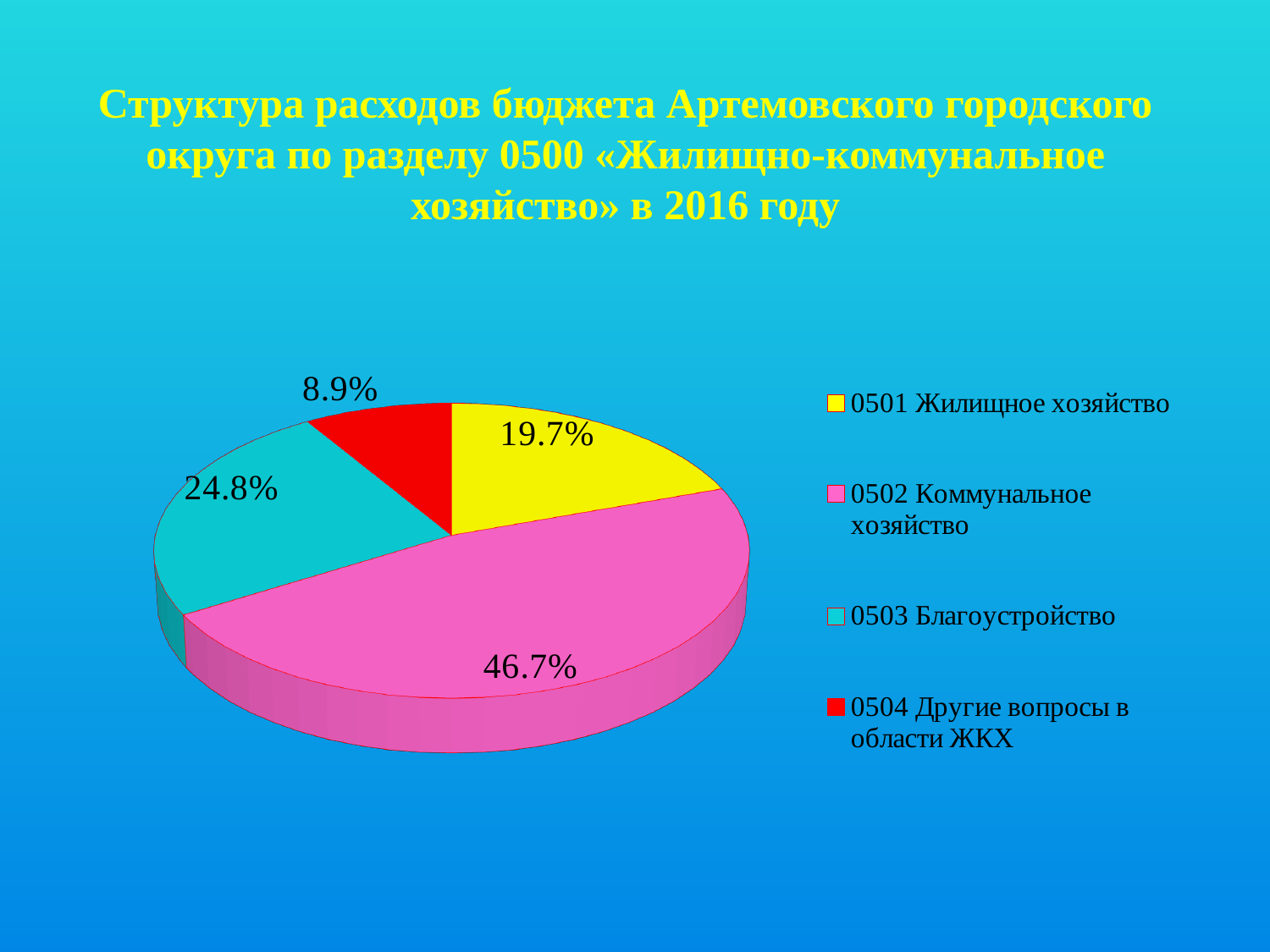
Which is larger: the share for 0501 Жилищное хозяйство or for 0503 Благоустройство? 0503 Благоустройство Which year does the chart title refer to? 2016 What share of the pie does 0504 Другие вопросы в области ЖКХ have? 8.9% Which category has the largest share of the pie? 0502 Коммунальное хозяйство How many categories are shown in the pie chart? 4 What share of the pie does 0501 Жилищное хозяйство have? 19.7% What share of the pie does 0503 Благоустройство have? 24.8% What colour is the slice for 0503 Благоустройство? Teal What is the difference in percentage points between 0502 Коммунальное хозяйство and 0503 Благоустройство? 21.9 What kind of chart is shown on the slide? Pie chart Which category has the smallest share of the pie? 0504 Другие вопросы в области ЖКХ What share of the pie does 0502 Коммунальное хозяйство have? 46.7%